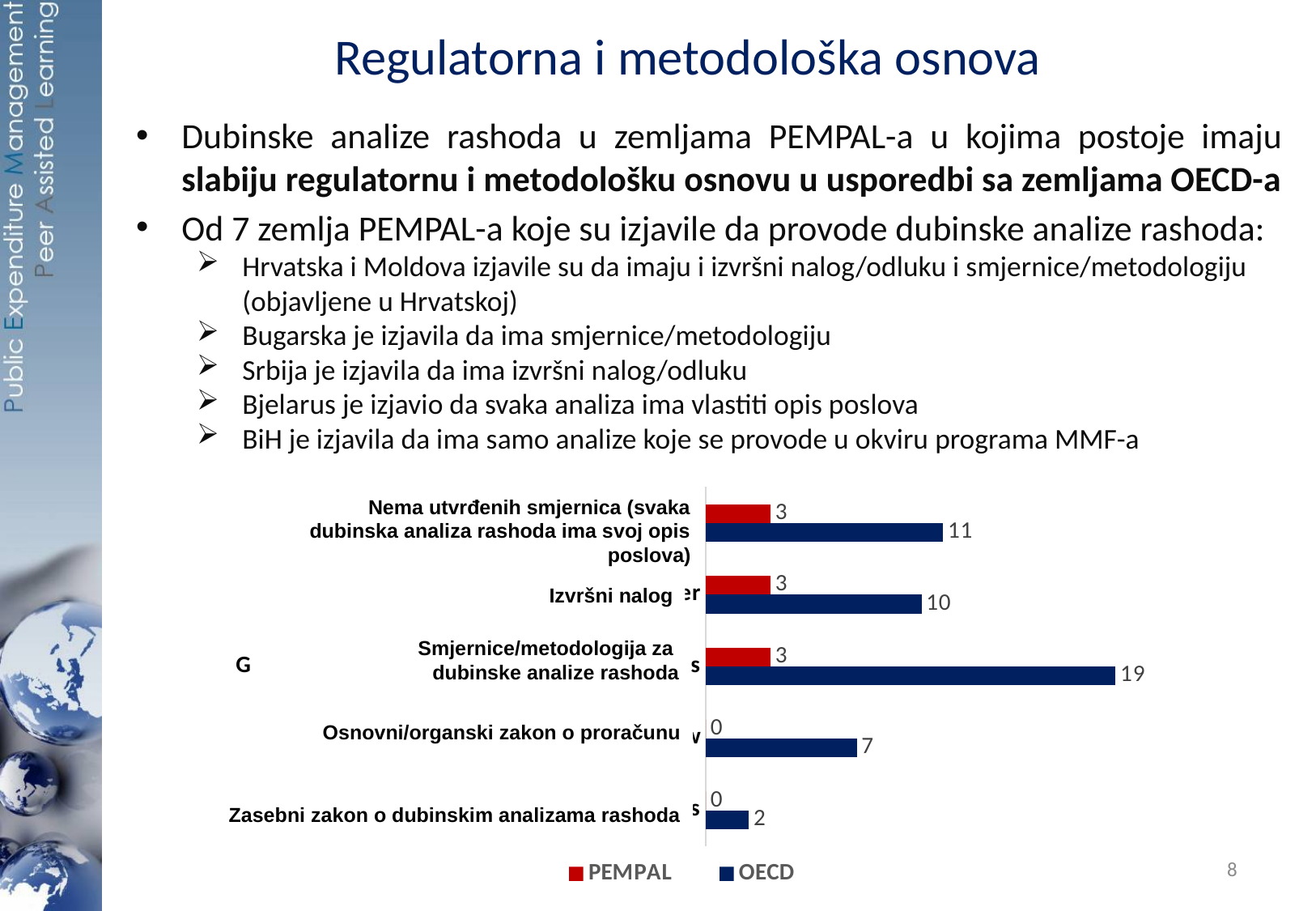
Which category has the highest OECD value? Smjernice/metodologija za dubinske analize rashoda What is the PEMPAL value for "Izvršni nalog"? 3 What is the OECD value for "Smjernice/metodologija za dubinske analize rashoda"? 19 Which is larger for "Izvršni nalog": the OECD value or the PEMPAL value? OECD What is the difference between the OECD and PEMPAL values for "Nema utvrđenih smjernica (svaka dubinska analiza rashoda ima svoj opis poslova)"? 8 How many series does the legend list? 2 How many categories are shown in the chart? 5 Which colour represents the OECD series in the chart? Dark blue Which category has the lowest OECD value? Zasebni zakon o dubinskim analizama rashoda What is the PEMPAL value for "Zasebni zakon o dubinskim analizama rashoda"? 0 What is the OECD value for "Osnovni/organski zakon o proračunu"? 7 What type of chart is shown on the slide? Bar chart